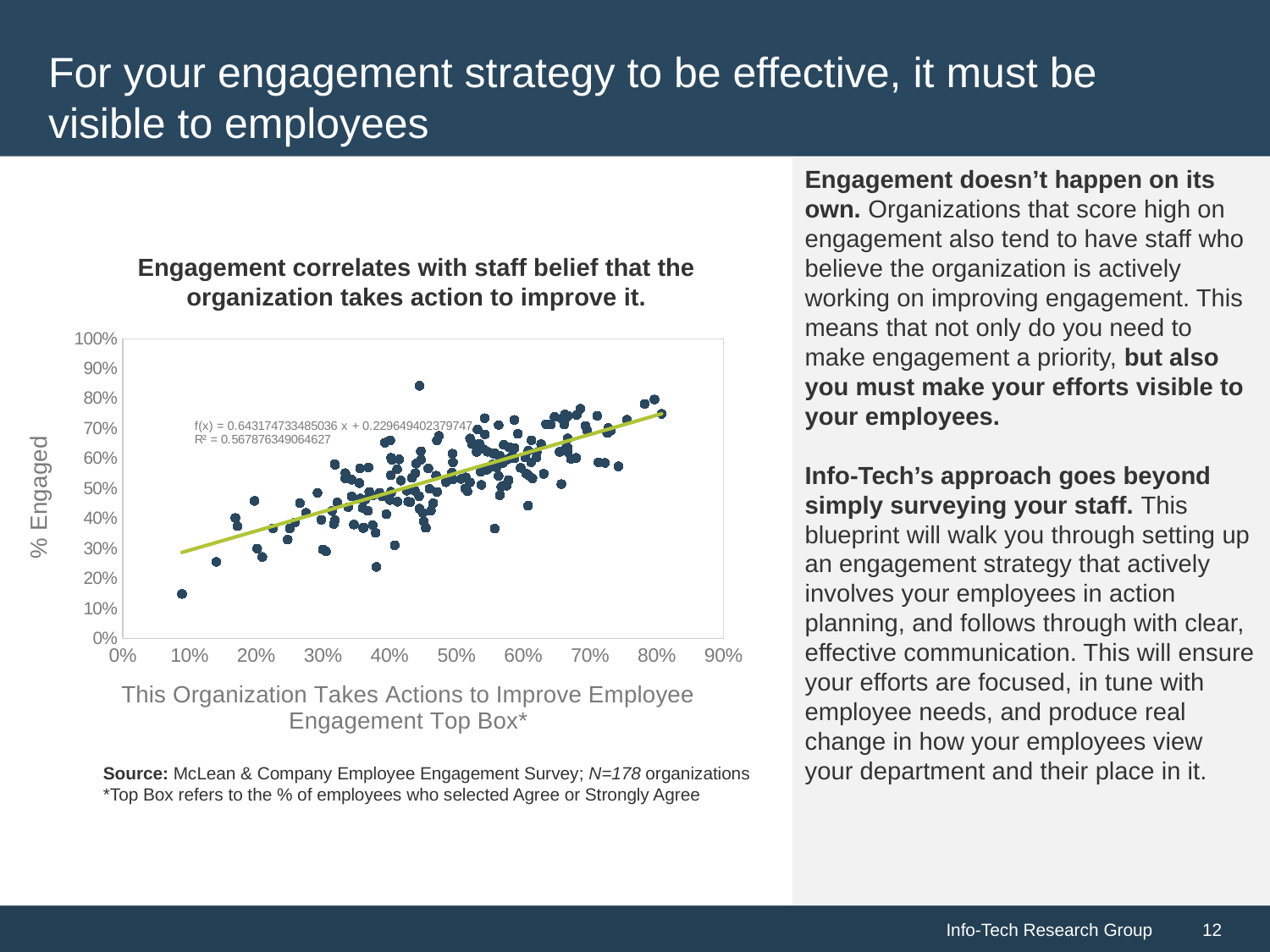
What is the trendline equation printed on the chart? f(x) = 0.643174733485036 x + 0.229649402379747 Is the lowest plotted point on the chart greater or less than 20% on the % Engaged axis? less Is the highest plotted point on the chart greater or less than 80% on the % Engaged axis? greater What kind of chart is shown on the slide? Scatter chart What is the R² value printed on the chart? R² = 0.567876349064627 What is the title of the chart? Engagement correlates with staff belief that the organization takes action to improve it. What is the label of the vertical axis of the chart? % Engaged Do the plotted values of % Engaged generally rise or fall as the x-axis value increases? Rise